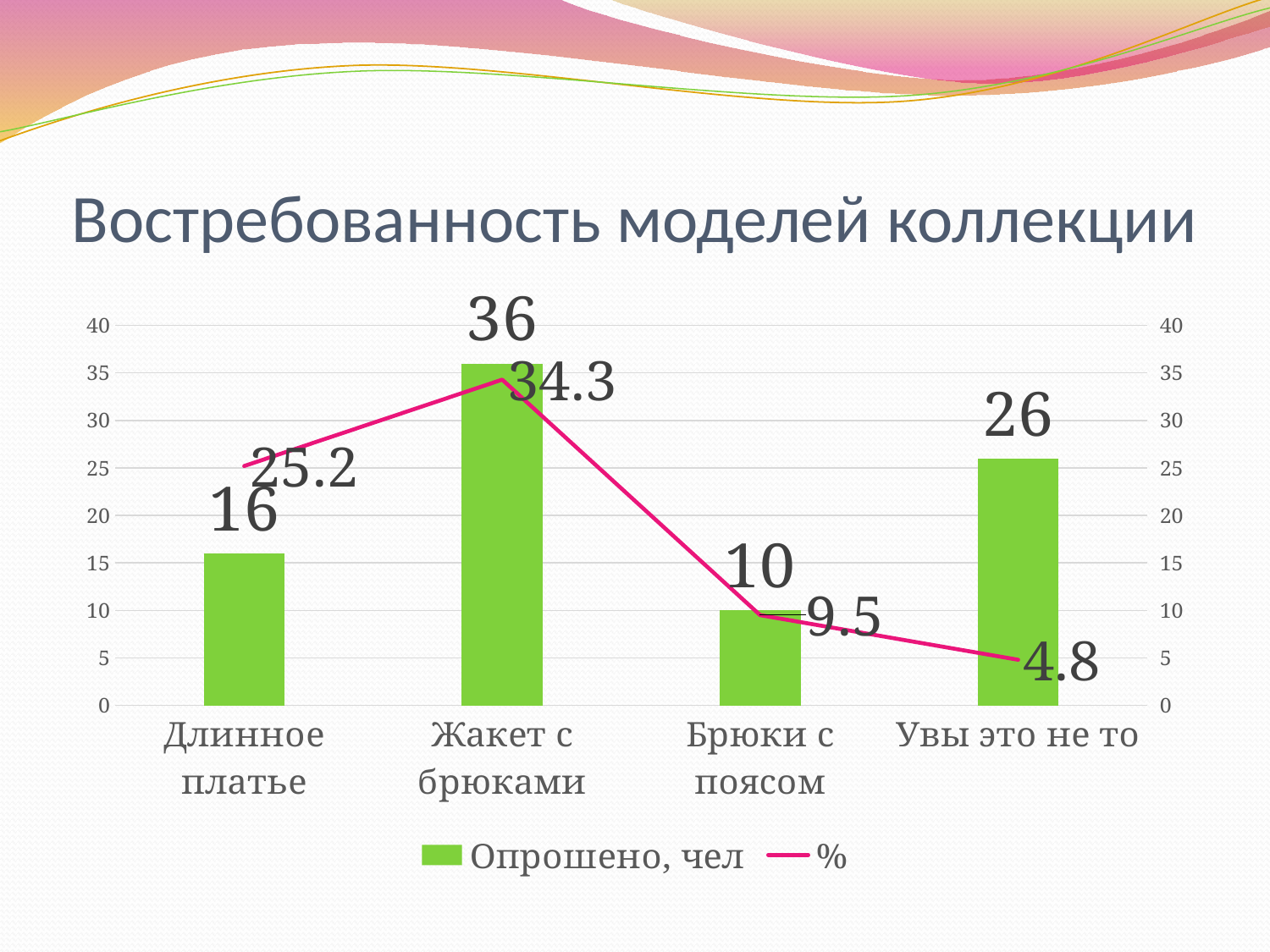
What is the title of the slide? Востребованность моделей коллекции Which category has the highest "Опрошено, чел" value? Жакет с брюками Which category has the lowest "%" value? Увы это не то Which is larger: the "Опрошено, чел" value for "Длинное платье" or for "Увы это не то"? Увы это не то What is the difference between the "Опрошено, чел" values for "Жакет с брюками" and "Брюки с поясом"? 26 How many categories are shown on the x axis? 4 What is the "%" value for "Увы это не то"? 4.8 What is the "%" value for "Длинное платье"? 25.2 How many series does the legend list? 2 What colour are the bars for "Опрошено, чел"? green What kind of chart is used for the "Опрошено, чел" series? bar chart What is the value of "Опрошено, чел" for "Жакет с брюками"? 36